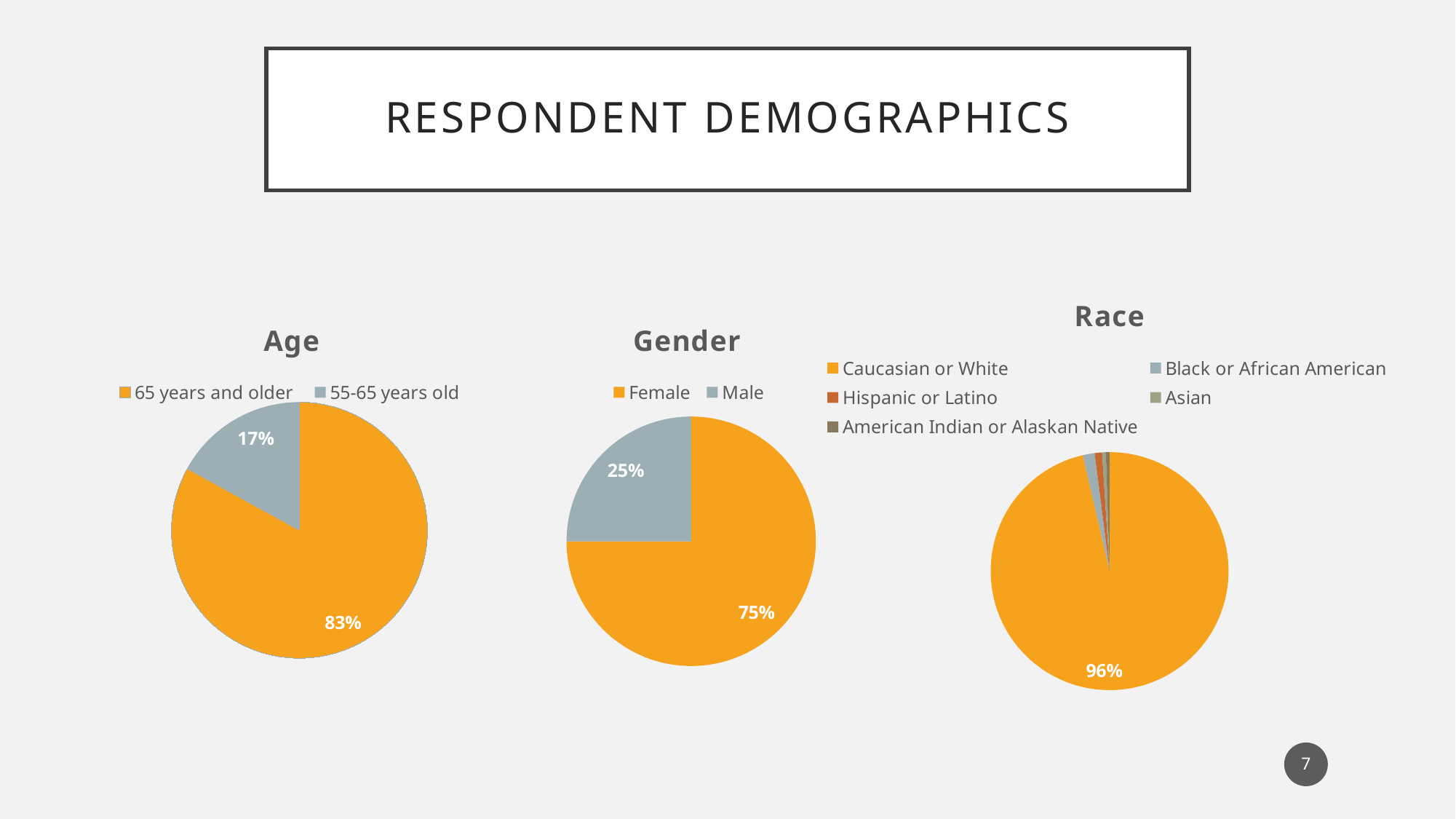
In the Age chart, what share of respondents are 55-65 years old? 17% In the Gender chart, what percentage of respondents are Male? 25% How many categories does the legend of the Race chart list? 5 What type of chart is the Gender chart? Pie chart In the Gender chart, which gender has the smaller share? Male In the Gender chart, how many percentage points larger is the Female share than the Male share? 50 In the Age chart, what share of respondents are 65 years and older? 83% In the Gender chart, what percentage of respondents are Female? 75% In the Age chart, what is the difference in percentage points between the 65 years and older share and the 55-65 years old share? 66 In the Age chart, which age group has the larger share? 65 years and older In the Race chart, what share of respondents are Caucasian or White? 96% In the Race chart, which race category has the largest share? Caucasian or White